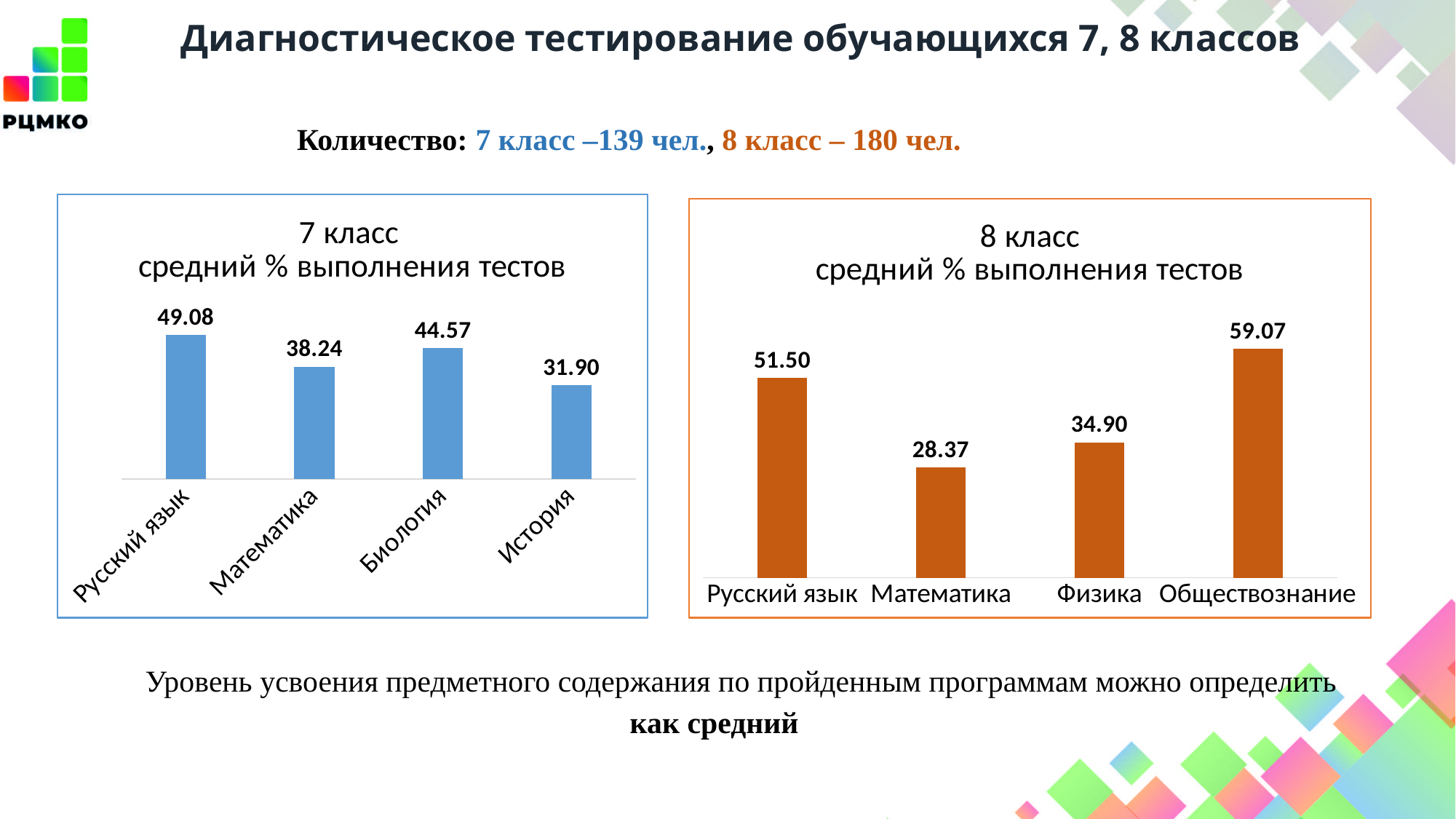
What kind of chart is the left chart (7 класс)? Bar chart What colour are the bars in the right chart (8 класс)? Orange In the right chart (8 класс), what is the difference between the values for Обществознание and Русский язык? 7.57 In the left chart (7 класс), which category has the lowest value? История In the left chart (7 класс), which is larger: the value for Биология or the value for Математика? Биология In the left chart (7 класс), what is the value for История? 31.90 In the right chart (8 класс средний % выполнения тестов), what is the value for Физика? 34.90 In the right chart (8 класс), which category has the highest value? Обществознание How many categories are shown in the right chart (8 класс)? 4 In the left chart (7 класс), what is the difference between the values for Русский язык and Математика? 10.84 In the left chart (7 класс средний % выполнения тестов), what is the value for Русский язык? 49.08 In the right chart (8 класс), which category has the lowest value? Математика